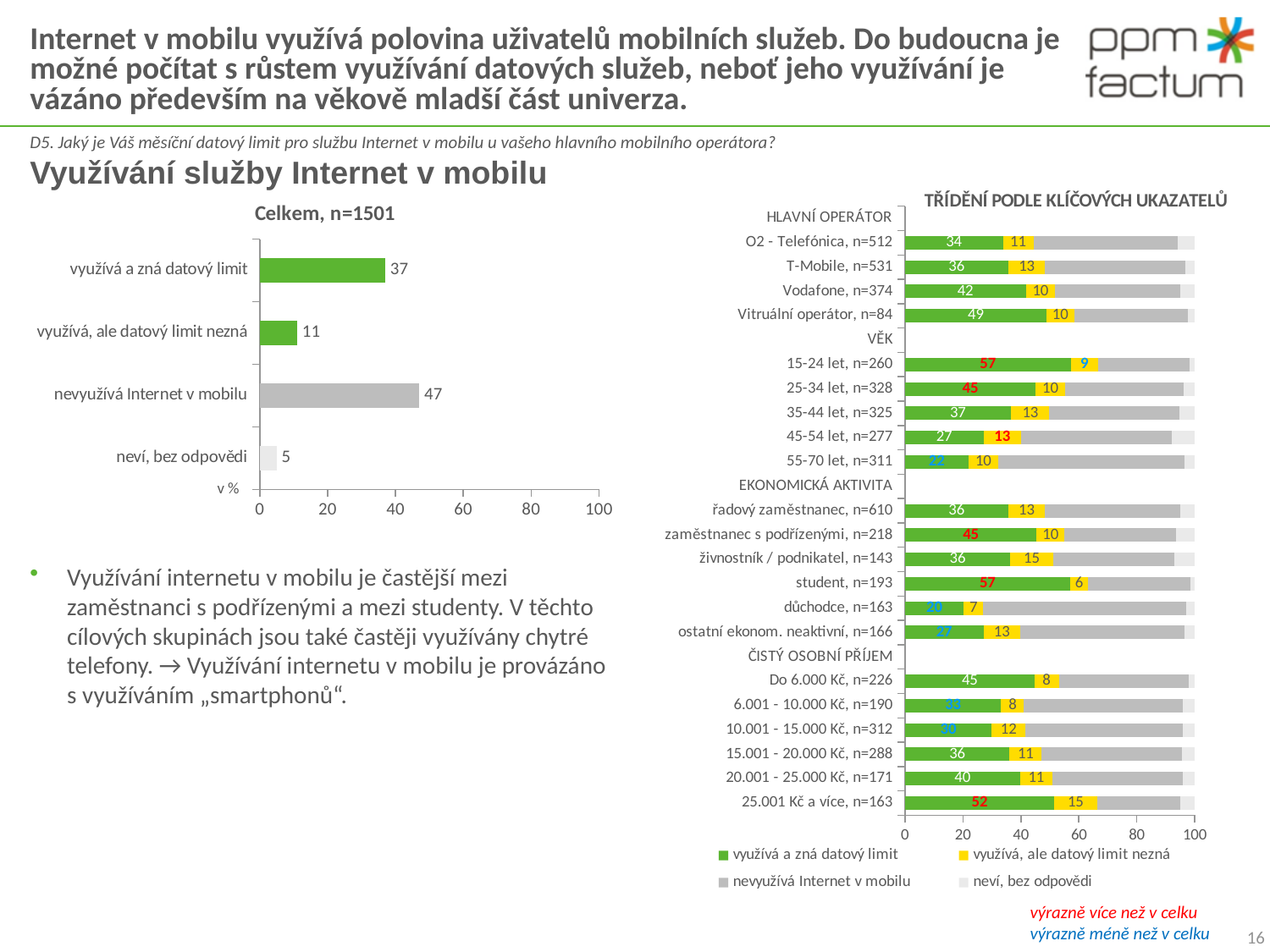
In the 'TŘÍDĚNÍ PODLE KLÍČOVÝCH UKAZATELŮ' chart, what colour represents 'využívá, ale datový limit nezná'? yellow In the 'TŘÍDĚNÍ PODLE KLÍČOVÝCH UKAZATELŮ' chart, what is the value of 'využívá, ale datový limit nezná' for 'živnostník / podnikatel, n=143'? 15 What kind of chart is the 'Celkem, n=1501' chart? bar chart In the 'TŘÍDĚNÍ PODLE KLÍČOVÝCH UKAZATELŮ' chart, how many series does the legend list? 4 In the 'TŘÍDĚNÍ PODLE KLÍČOVÝCH UKAZATELŮ' chart, what is the value of 'využívá a zná datový limit' for '15-24 let, n=260'? 57 In the 'TŘÍDĚNÍ PODLE KLÍČOVÝCH UKAZATELŮ' chart, which is larger for 'využívá a zná datový limit': 'Vodafone, n=374' or 'T-Mobile, n=531'? Vodafone, n=374 In the 'Celkem, n=1501' chart, what is the value for 'využívá a zná datový limit'? 37 In the 'Celkem, n=1501' chart, how many categories are shown? 4 In the 'Celkem, n=1501' chart, which category has the highest value? nevyužívá Internet v mobilu In the 'Celkem, n=1501' chart, what is the difference between 'nevyužívá Internet v mobilu' and 'využívá a zná datový limit'? 10 In the 'Celkem, n=1501' chart, which category has the lowest value? neví, bez odpovědi In the 'TŘÍDĚNÍ PODLE KLÍČOVÝCH UKAZATELŮ' chart, among the age groups (VĚK), which has the lowest value for 'využívá a zná datový limit'? 55-70 let, n=311